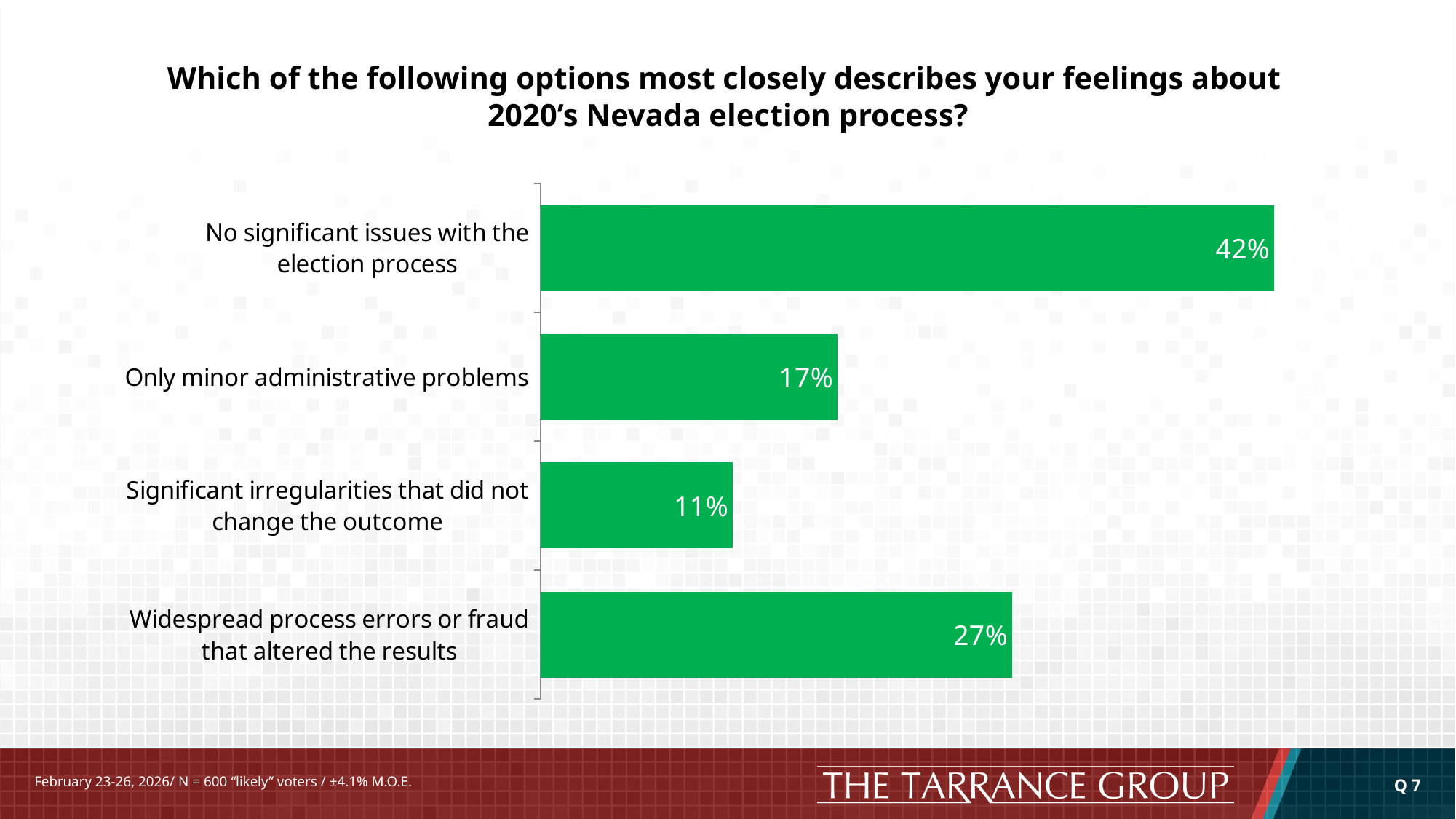
What percentage chose "Significant irregularities that did not change the outcome"? 11% Which is larger: the value for "Only minor administrative problems" or "Widespread process errors or fraud that altered the results"? Widespread process errors or fraud that altered the results What is the difference between the percentage for "No significant issues with the election process" and "Widespread process errors or fraud that altered the results"? 15% What is the value for "Only minor administrative problems"? 17% What percentage of respondents said there were no significant issues with the election process? 42% How many response options are shown in the chart? 4 What type of chart is shown on the slide? Bar chart What colour are the bars in the chart? Green What is the difference between "Only minor administrative problems" and "Significant irregularities that did not change the outcome"? 6% Which option has the lowest percentage? Significant irregularities that did not change the outcome What is the value for "Widespread process errors or fraud that altered the results"? 27% Which option has the highest percentage? No significant issues with the election process